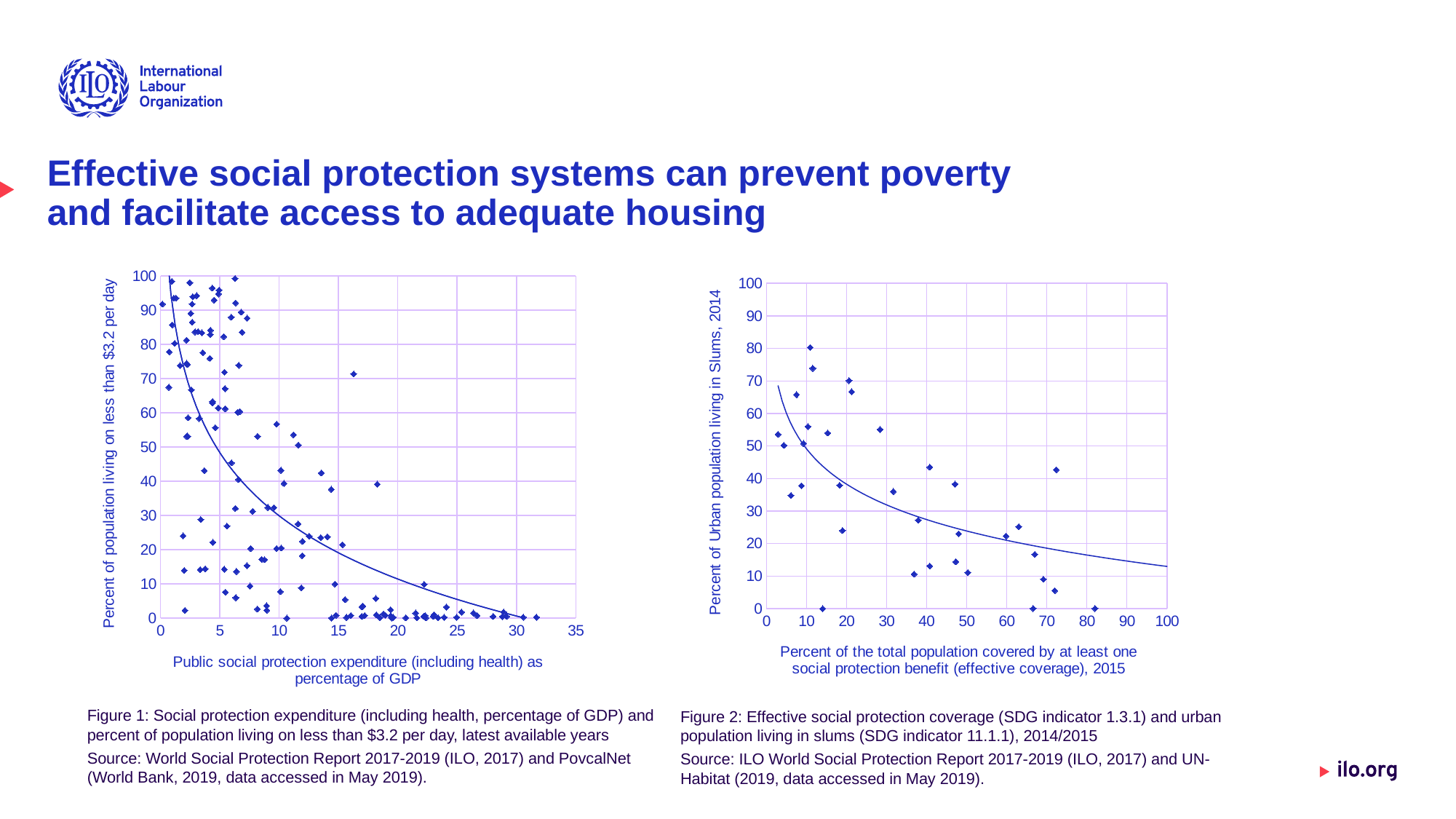
In Figure 1, does the fitted trend line rise or fall as public social protection expenditure increases? Fall What is the x-axis label of Figure 1? Public social protection expenditure (including health) as percentage of GDP What kind of chart is Figure 1? Scatter chart What is the y-axis label of Figure 2? Percent of Urban population living in Slums, 2014 How many charts are shown on the slide? 2 What kind of chart is Figure 2? Scatter chart In Figure 1, is the highest plotted point greater or less than 90 on the y axis? greater In Figure 2, is the highest plotted point greater or less than 70 on the y axis? greater In Figure 2, does the fitted trend line rise or fall as effective coverage increases? Fall